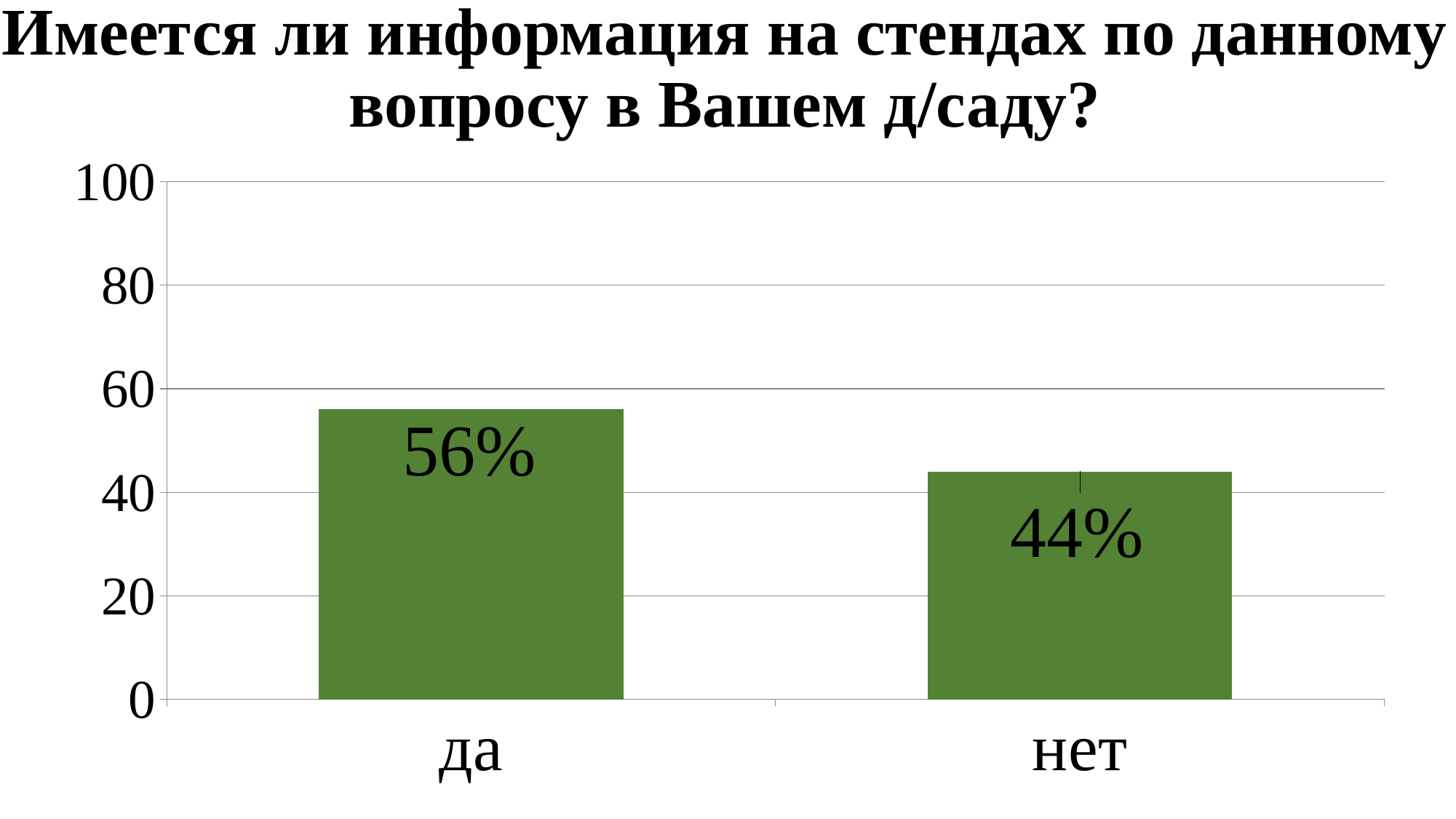
What is the highest value shown on the vertical axis? 100 What is the difference between the values for "да" and "нет"? 12% How many categories are shown on the x axis? 2 Which category has the lowest value? нет Which is larger, the value for "да" or the value for "нет"? да Is the value for "нет" greater or less than 40? greater What is the value for "нет"? 44% What kind of chart is shown on the slide? bar chart Is the value for "да" greater or less than 60? less What colour are the bars in the chart? green What is the value for "да"? 56% Which category has the highest value? да